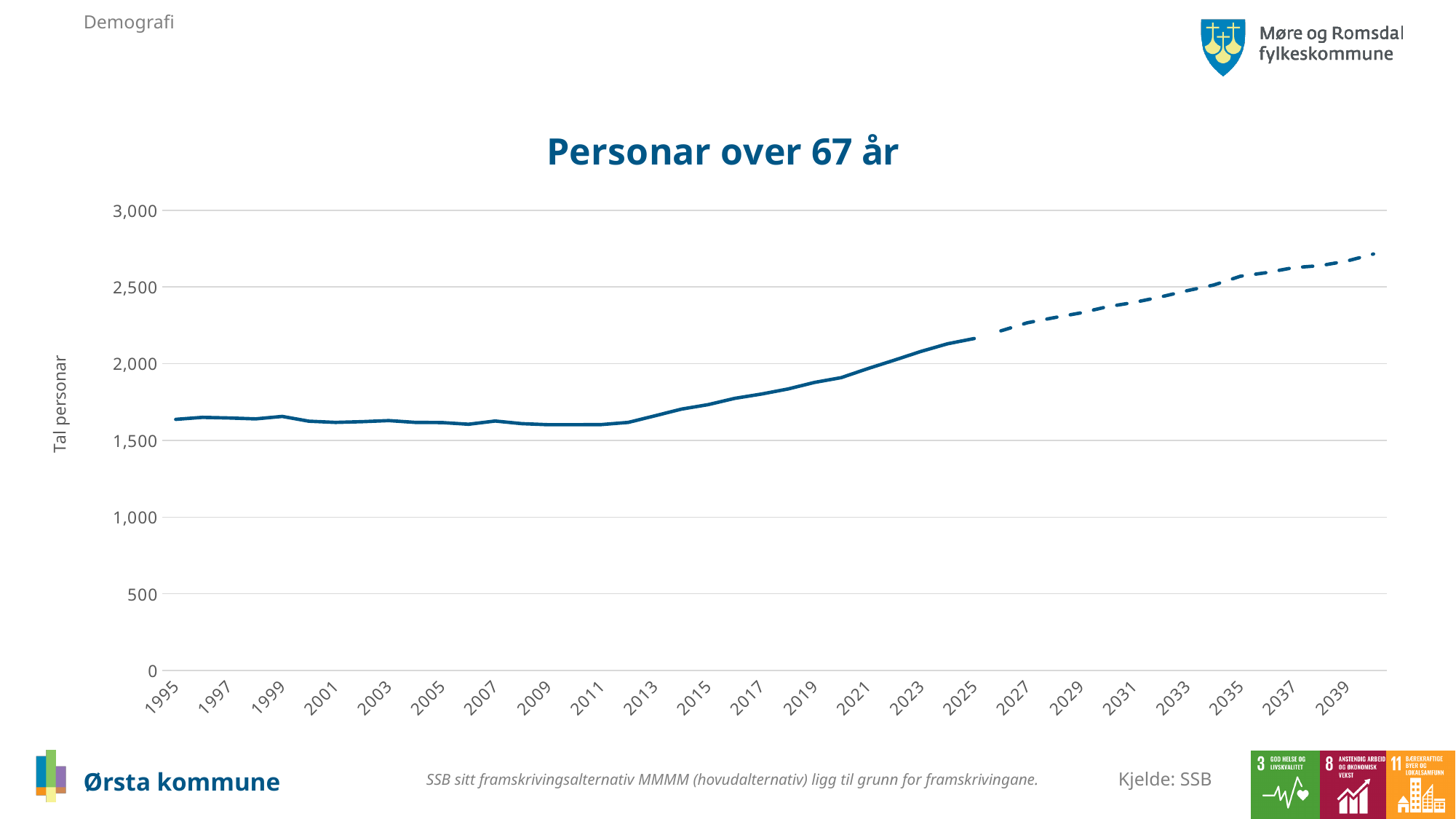
Is the value for 2011 greater or less than 2,000? less Which year has the larger value, 1995 or 2025? 2025 What kind of chart is shown on the slide? line chart Is the value for 2025 greater or less than 2,000? greater Is the value for 2031 greater or less than 2,500? less What is the label on the vertical axis of the chart? Tal personar How many year labels are shown on the x axis? 23 Do the values generally rise or fall from 2011 to 2039 along the x axis? rise What is the title of the chart? Personar over 67 år